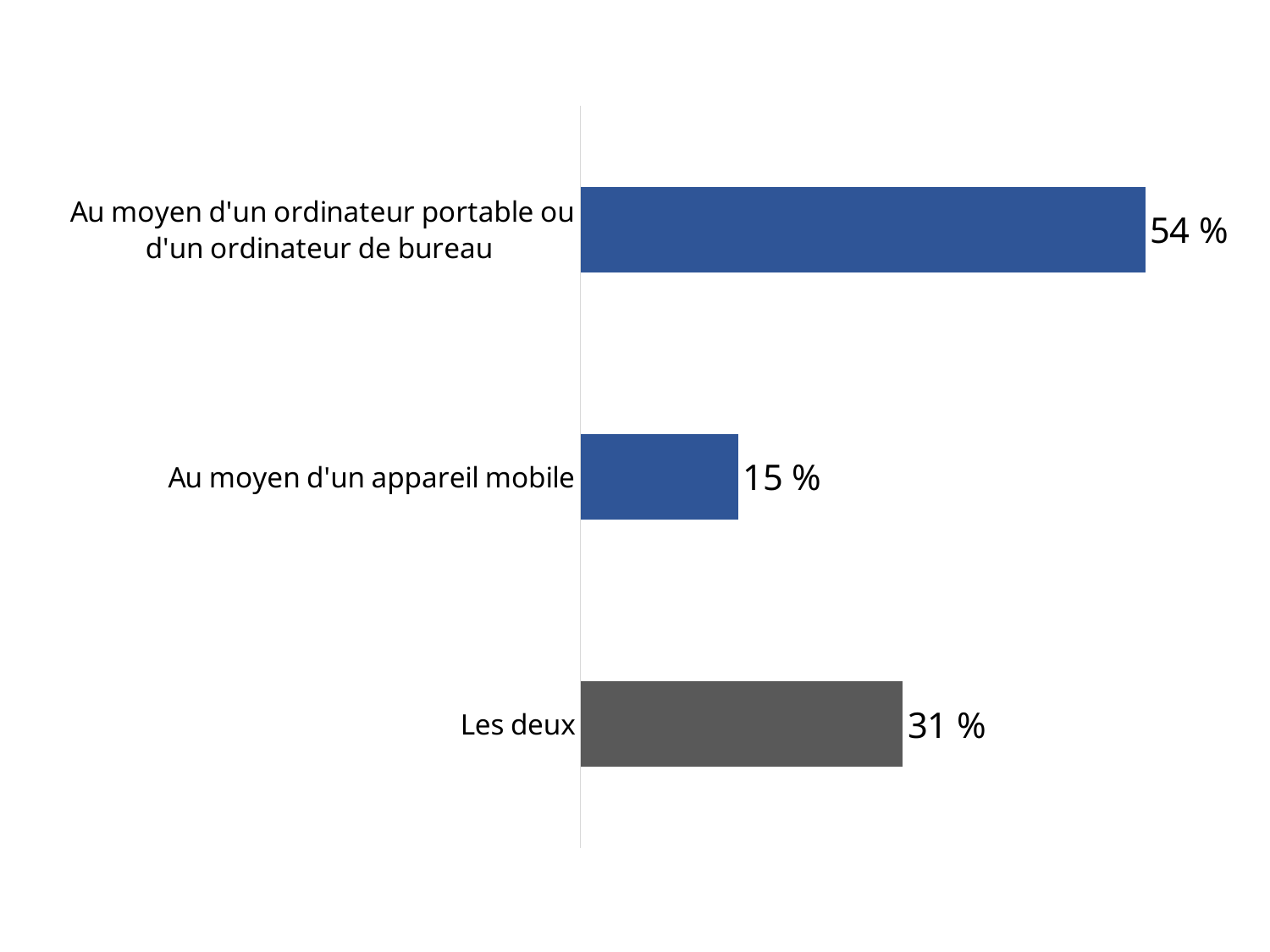
Which category has the highest value? Au moyen d'un ordinateur portable ou d'un ordinateur de bureau What kind of chart is shown on the slide? Bar chart How many categories are shown in the chart? 3 What is the value for "Au moyen d'un appareil mobile"? 15 % Which category has the lowest value? Au moyen d'un appareil mobile What is the difference between the values for "Les deux" and "Au moyen d'un appareil mobile"? 16 % What is the value for "Au moyen d'un ordinateur portable ou d'un ordinateur de bureau"? 54 % Which is larger: the value for "Les deux" or the value for "Au moyen d'un appareil mobile"? Les deux What is the difference between the values for "Au moyen d'un ordinateur portable ou d'un ordinateur de bureau" and "Les deux"? 23 % What colour is the bar for "Les deux"? Grey What is the total of the three values shown in the chart? 100 % What is the value for "Les deux"? 31 %